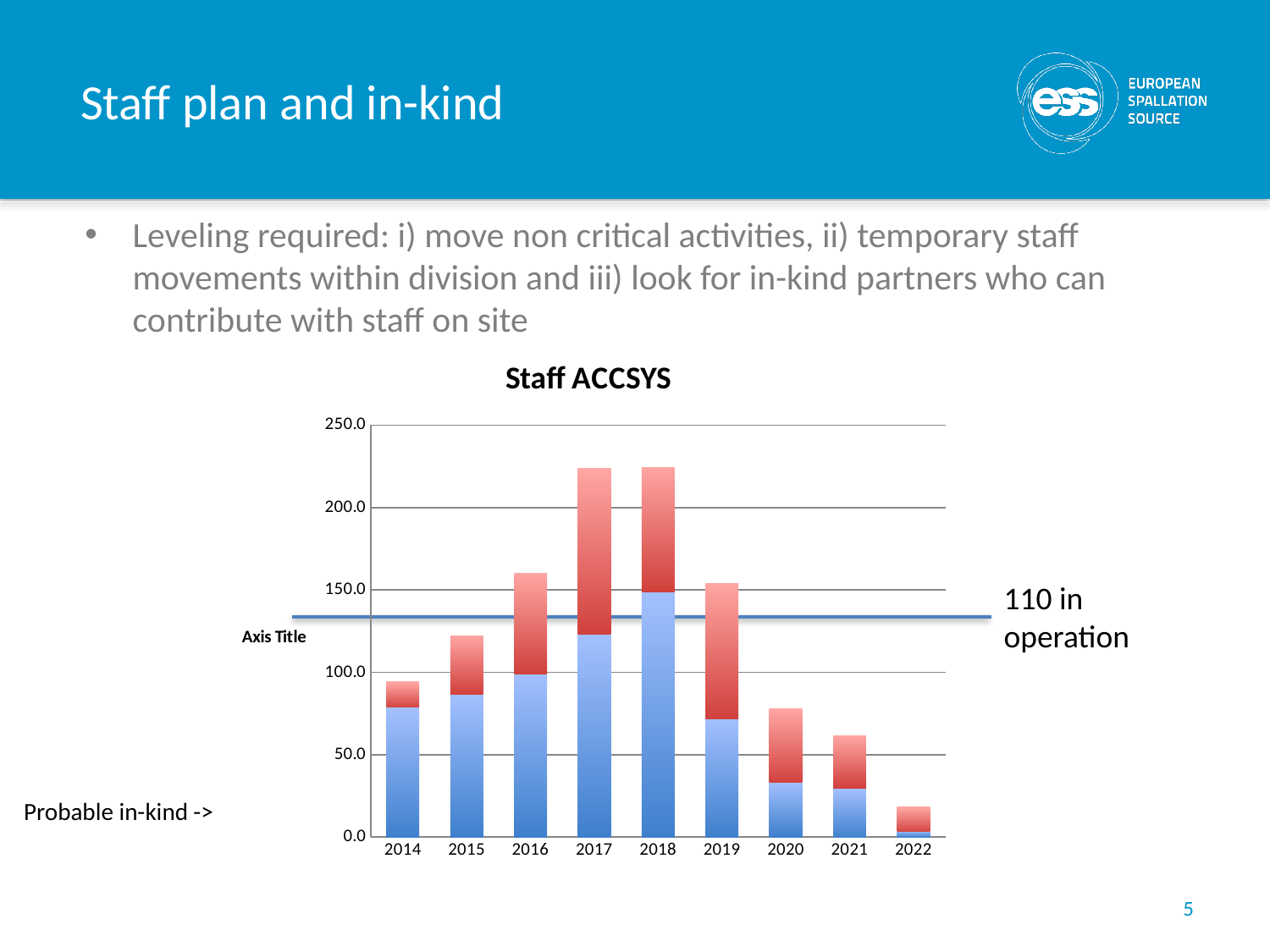
What label is given to the horizontal line drawn across the chart? 110 in operation Which year has the lowest total bar in the chart? 2022 What kind of chart is shown on the slide? Stacked bar chart Is the total bar for 2022 greater or less than 50? less Do the total bars rise or fall from 2018 to 2022? fall Is the total bar for 2017 greater or less than 200? greater Which year has the larger total bar, 2015 or 2020? 2015 Is the total bar for 2015 greater or less than 100? greater What is the title of the chart? Staff ACCSYS How many years are shown on the x axis of the chart? 9